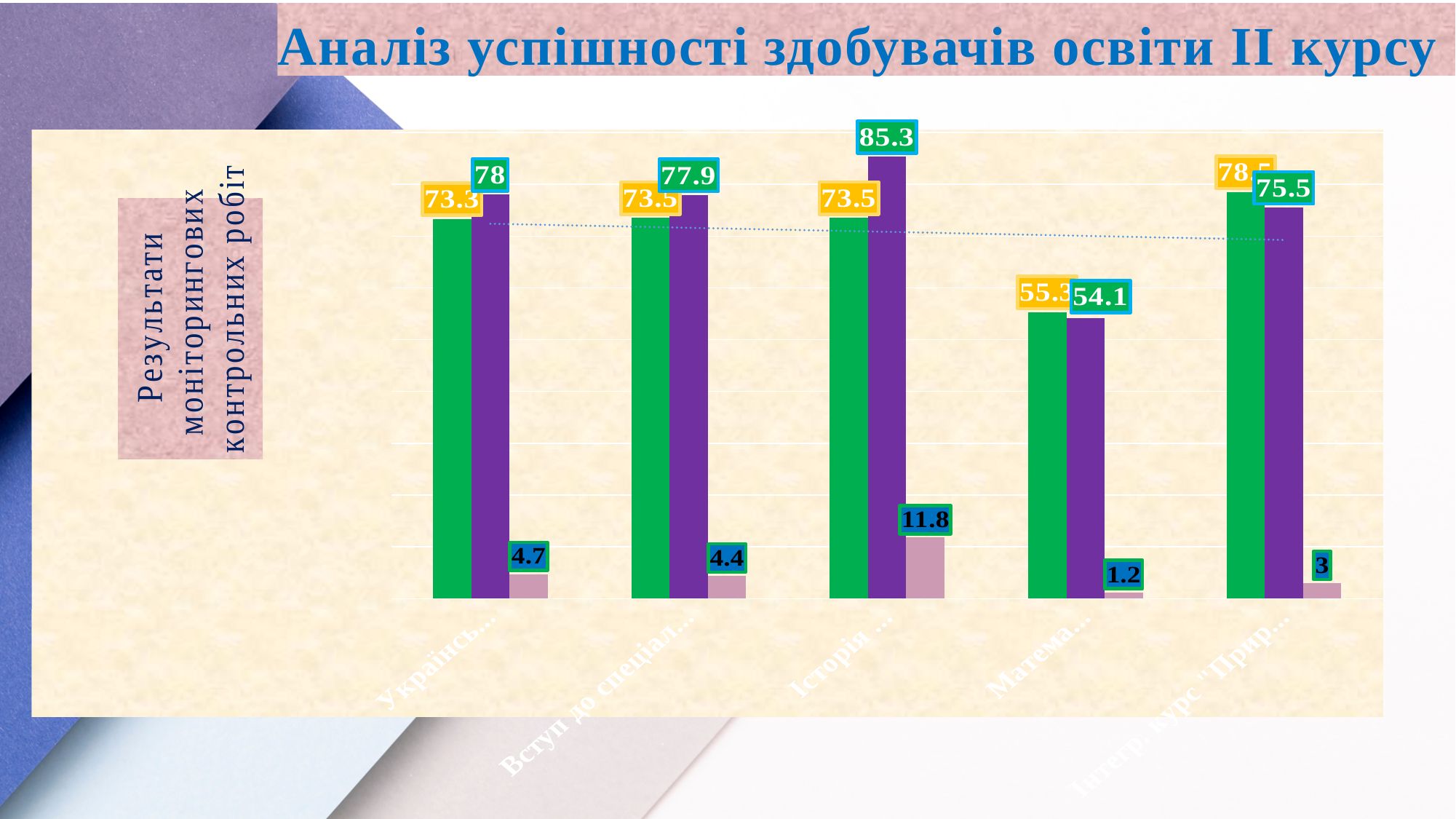
What is the value of the green bar for the first category (Українсь...)? 73.3 What is the difference between the purple bar (85.3) and the green bar (73.5) for the third category (Історія ...)? 11.8 What kind of chart is shown on the slide? bar chart What is the value of the purple bar for the third category (Історія ...)? 85.3 Which category has the highest purple bar? Історія ... What is the value of the purple bar for the fourth category (Матема...)? 54.1 What is the value of the pink bar for the fifth category (Інтегр. курс "Прир...)? 3 What is the value of the pink bar for the third category (Історія ...)? 11.8 For the fourth category (Матема...), which is larger: the green bar or the purple bar? the green bar (55.3) How many categories are shown along the x axis of the chart? 5 What is the difference between the pink bars of the first category (4.7) and the second category (4.4)? 0.3 Which category has the lowest pink bar? Матема...